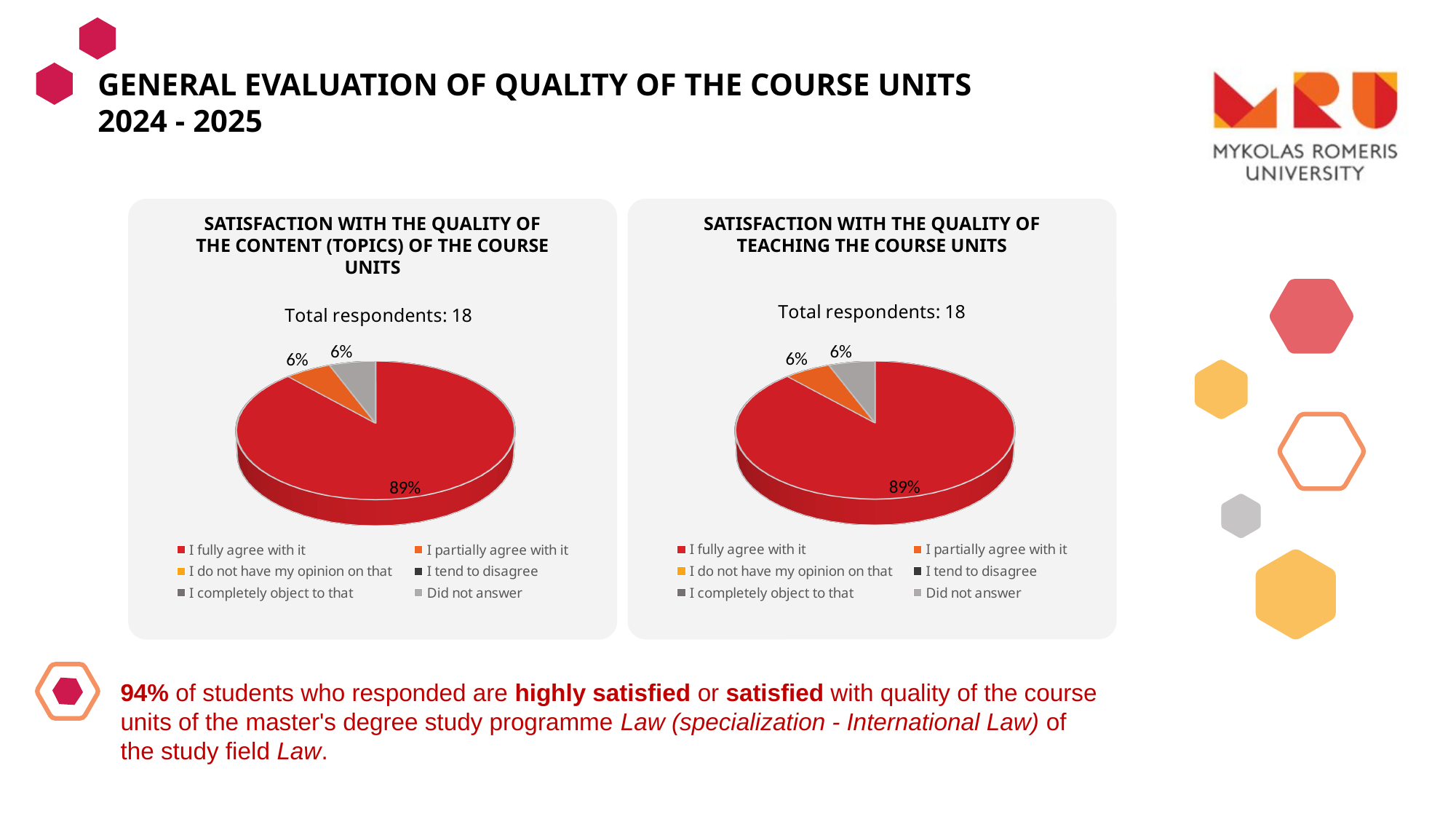
In the right chart (teaching the course units), which response has the largest slice? I fully agree with it In the left chart (content of the course units), which response has the largest slice? I fully agree with it How many entries does the legend list in the left chart (content of the course units)? 6 In the chart titled 'Satisfaction with the quality of the content (topics) of the course units', what share of respondents chose 'I fully agree with it'? 89% In the left chart (content of the course units), what is the difference between the 'I fully agree with it' share and the 'I partially agree with it' share? 83% In the left chart (content of the course units), how many slices are shown in the pie? 3 In the right chart (teaching the course units), what share of respondents did not answer? 6% What type of chart is used in the 'Satisfaction with the quality of teaching the course units' panel? Pie chart In the right chart (teaching the course units), which colour represents 'I fully agree with it'? Red In the left chart (content of the course units), what share of respondents chose 'I partially agree with it'? 6% How many total respondents are reported for the 'Satisfaction with the quality of teaching the course units' chart? 18